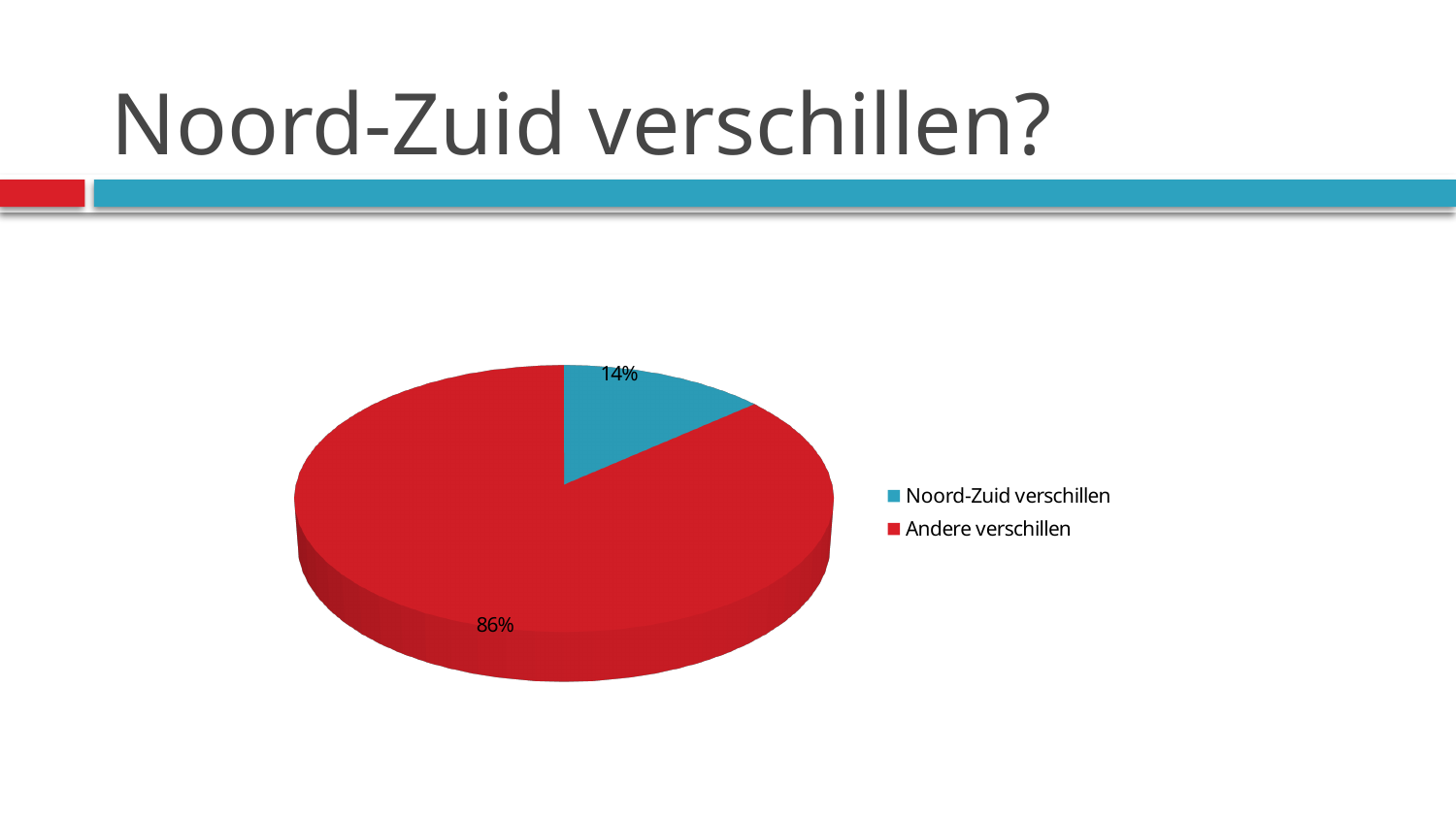
What kind of chart is shown on the slide? pie chart What is the title of the slide containing the chart? Noord-Zuid verschillen? What share of the pie does "Noord-Zuid verschillen" represent? 14% Which slice is the smallest? Noord-Zuid verschillen How many entries does the legend list? 2 How many slices does the pie chart have? 2 Which slice is the largest? Andere verschillen What colour is the "Noord-Zuid verschillen" slice? blue What is the difference in percentage points between "Andere verschillen" and "Noord-Zuid verschillen"? 72 Which is larger, "Noord-Zuid verschillen" or "Andere verschillen"? Andere verschillen What share of the pie does "Andere verschillen" represent? 86%